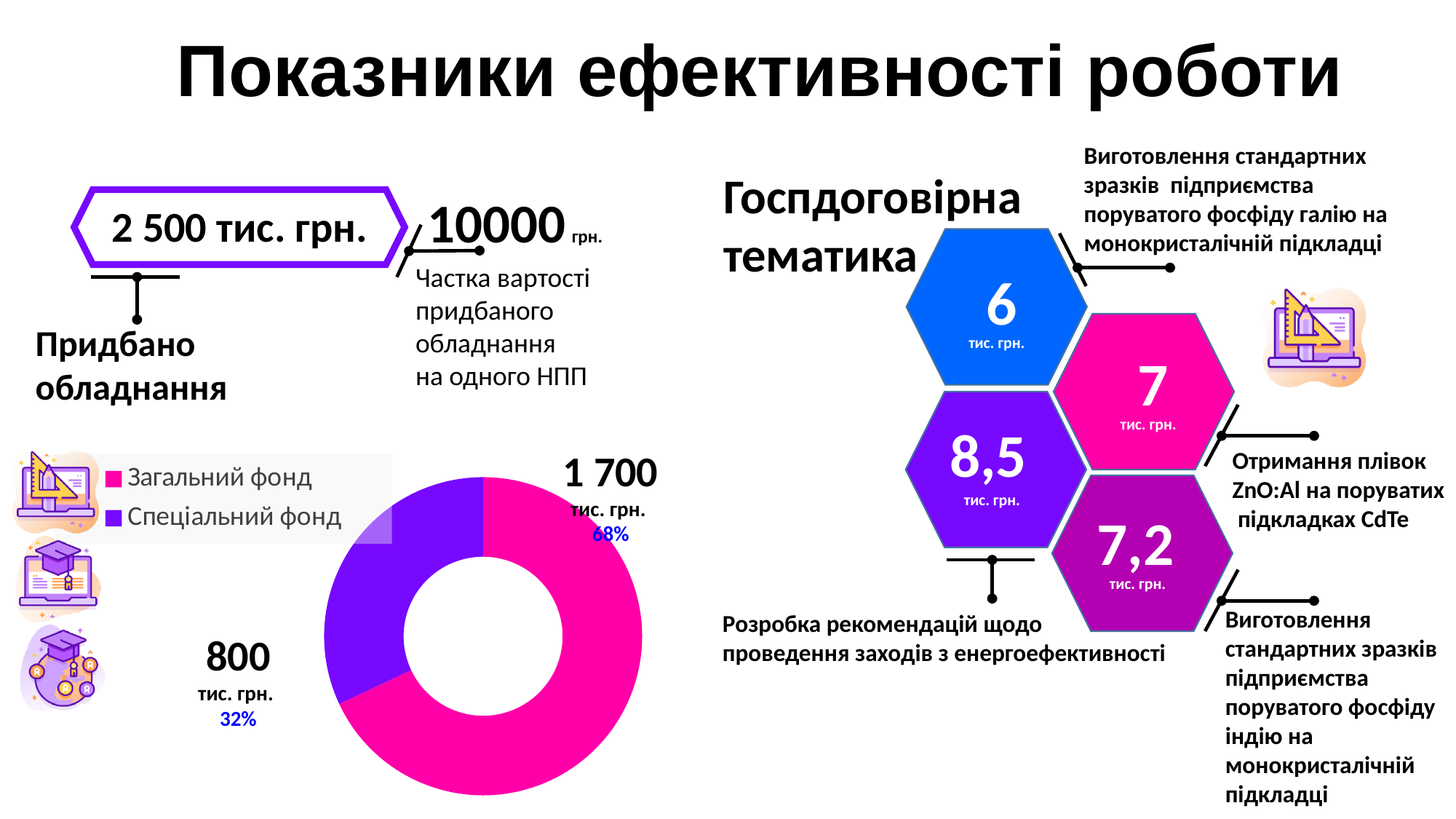
What share of the donut chart does Загальний фонд represent? 68% What share of the donut chart does Спеціальний фонд represent? 32% Which category in the donut chart has the smallest value? Спеціальний фонд How many entries does the legend of the donut chart list? 2 What is the value for Загальний фонд in the donut chart? 1 700 тис. грн. What kind of chart is shown on the left side of the slide? Donut (pie) chart What is the value for Спеціальний фонд in the donut chart? 800 тис. грн. What colour represents Спеціальний фонд in the donut chart? Purple Which is larger in the donut chart: Загальний фонд or Спеціальний фонд? Загальний фонд Which category in the donut chart has the largest value? Загальний фонд What is the difference between Загальний фонд and Спеціальний фонд in the donut chart? 900 тис. грн. How many categories does the donut chart show? 2